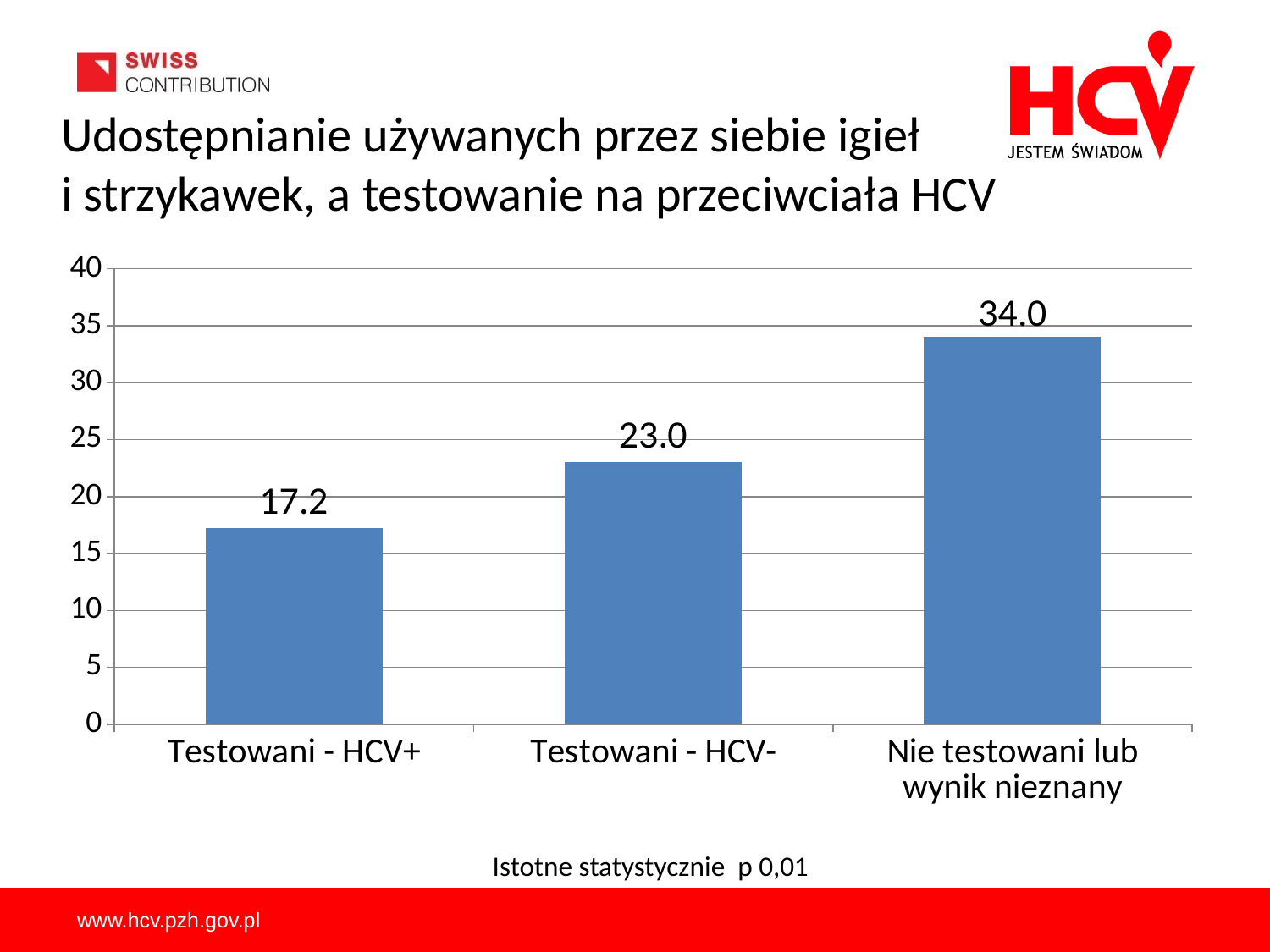
What is the difference between the values for "Testowani - HCV-" and "Testowani - HCV+"? 5.8 Which category has the highest value? Nie testowani lub wynik nieznany Which is larger, the value for "Testowani - HCV-" or for "Testowani - HCV+"? Testowani - HCV- What is the value for "Testowani - HCV-"? 23.0 What kind of chart is shown on the slide? bar chart What is the difference between the values for "Nie testowani lub wynik nieznany" and "Testowani - HCV+"? 16.8 Do the values rise or fall from left to right along the x axis? rise How many categories are shown on the x axis? 3 Which category has the lowest value? Testowani - HCV+ What is the value for "Testowani - HCV+"? 17.2 Is the value for "Testowani - HCV-" greater or less than 25? less What is the value for "Nie testowani lub wynik nieznany"? 34.0